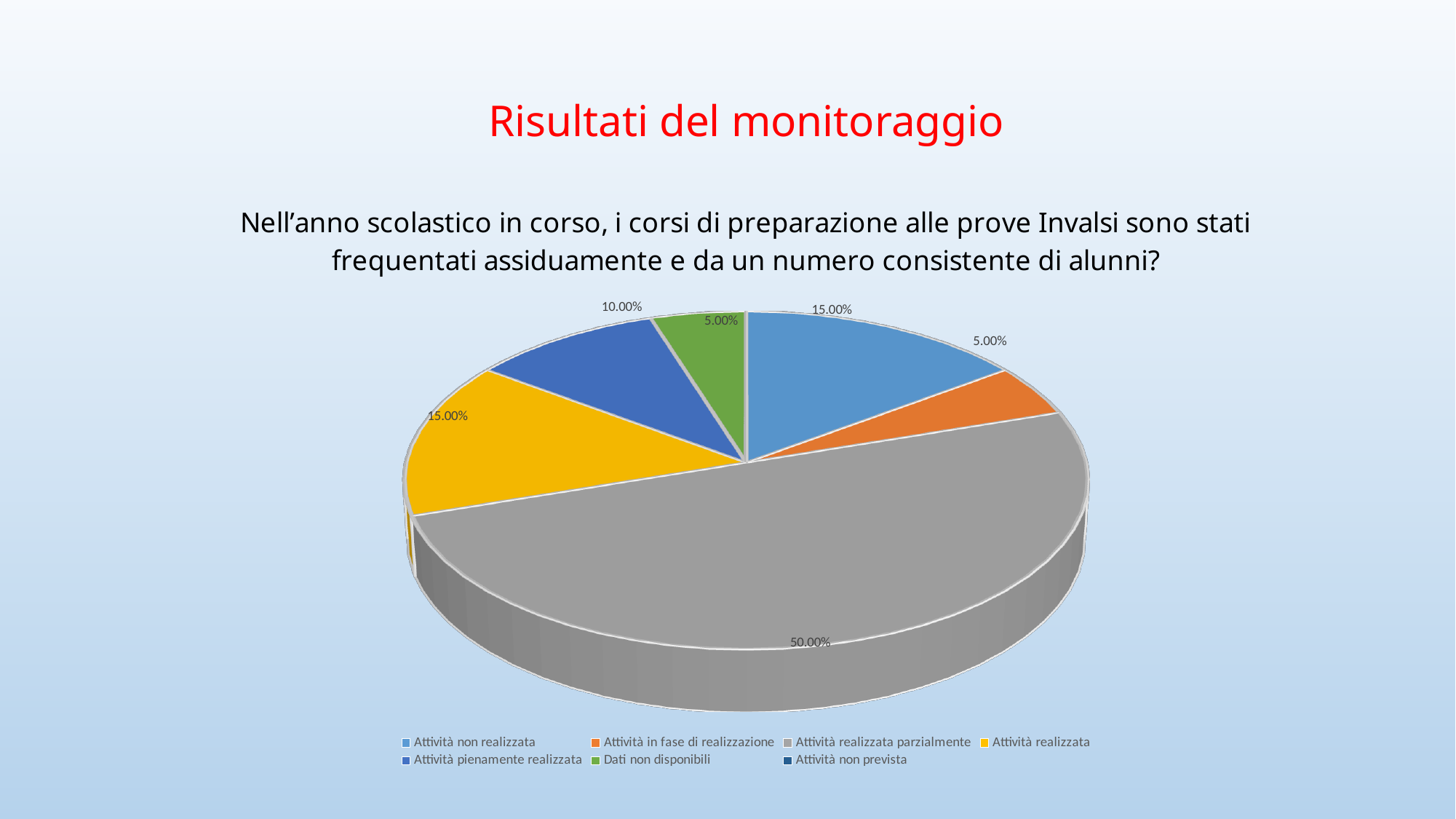
What colour is the slice for 'Attività realizzata'? Yellow What percentage is shown for 'Attività non realizzata'? 15.00% What percentage of the pie corresponds to 'Attività realizzata parzialmente'? 50.00% What type of chart is shown on the slide? Pie chart What is the difference between the share for 'Attività realizzata parzialmente' and the share for 'Attività realizzata'? 35.00% Which category has the largest share of the pie? Attività realizzata parzialmente What percentage is shown for 'Dati non disponibili'? 5.00% What percentage is shown for 'Attività pienamente realizzata'? 10.00% Which is larger: the share for 'Attività realizzata' or the share for 'Attività pienamente realizzata'? Attività realizzata How many entries does the legend list? 7 What percentage is shown for 'Attività in fase di realizzazione'? 5.00% What is the title of the slide? Risultati del monitoraggio